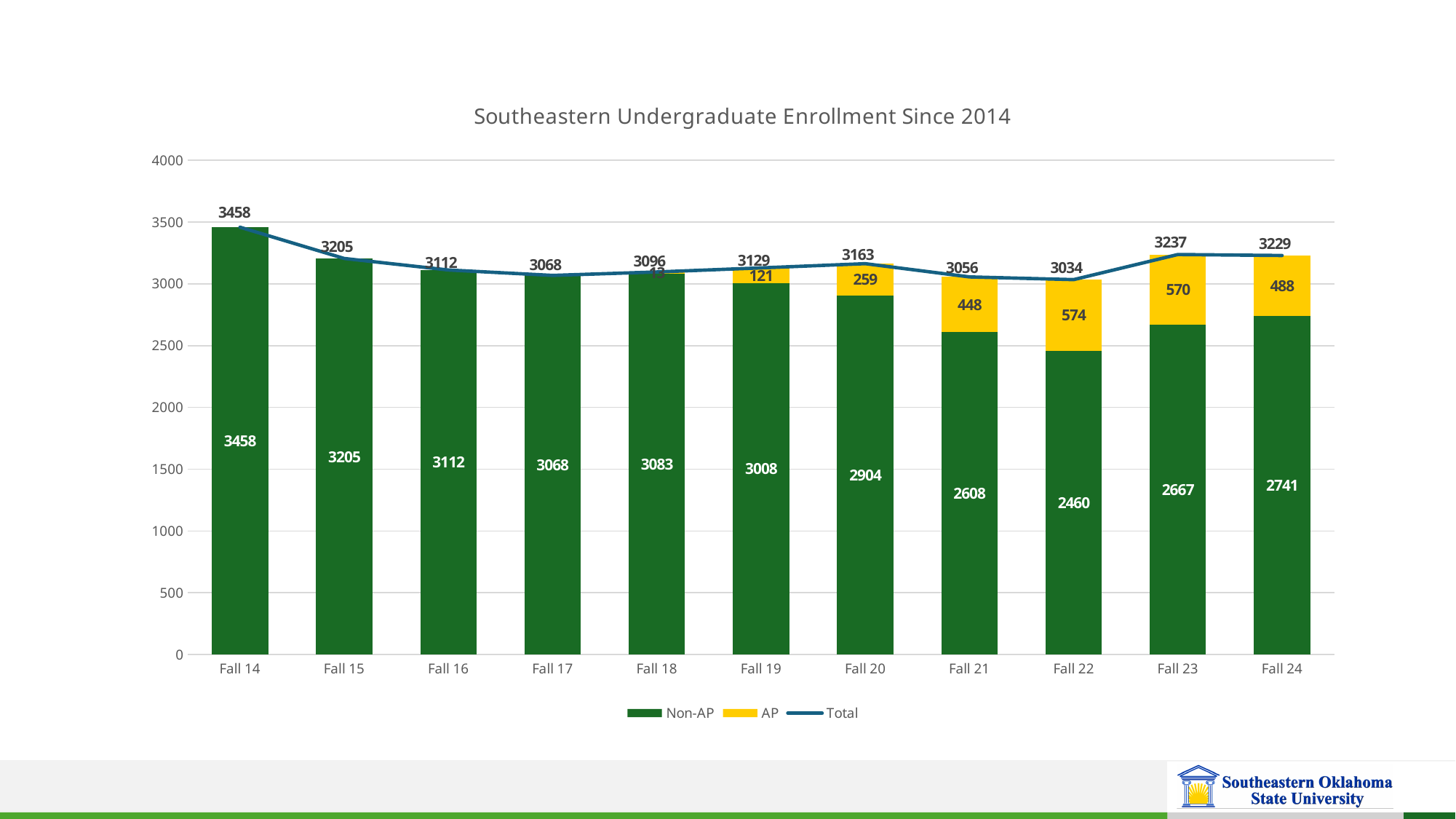
How many terms are shown on the x axis? 11 What is the difference between the Non-AP enrollment in Fall 14 and Fall 24? 717 What is the AP enrollment for Fall 21? 448 Is the Non-AP enrollment for Fall 20 greater or less than 3000? less What is the title of the chart? Southeastern Undergraduate Enrollment Since 2014 What is the Non-AP enrollment for Fall 22? 2460 Which term has the highest Total enrollment? Fall 14 How many series does the legend list? 3 Which is larger, the AP enrollment in Fall 22 or in Fall 23? Fall 22 What is the Total enrollment for Fall 23? 3237 What kind of chart is this? Stacked bar chart with a line Which term has the lowest Non-AP enrollment? Fall 22